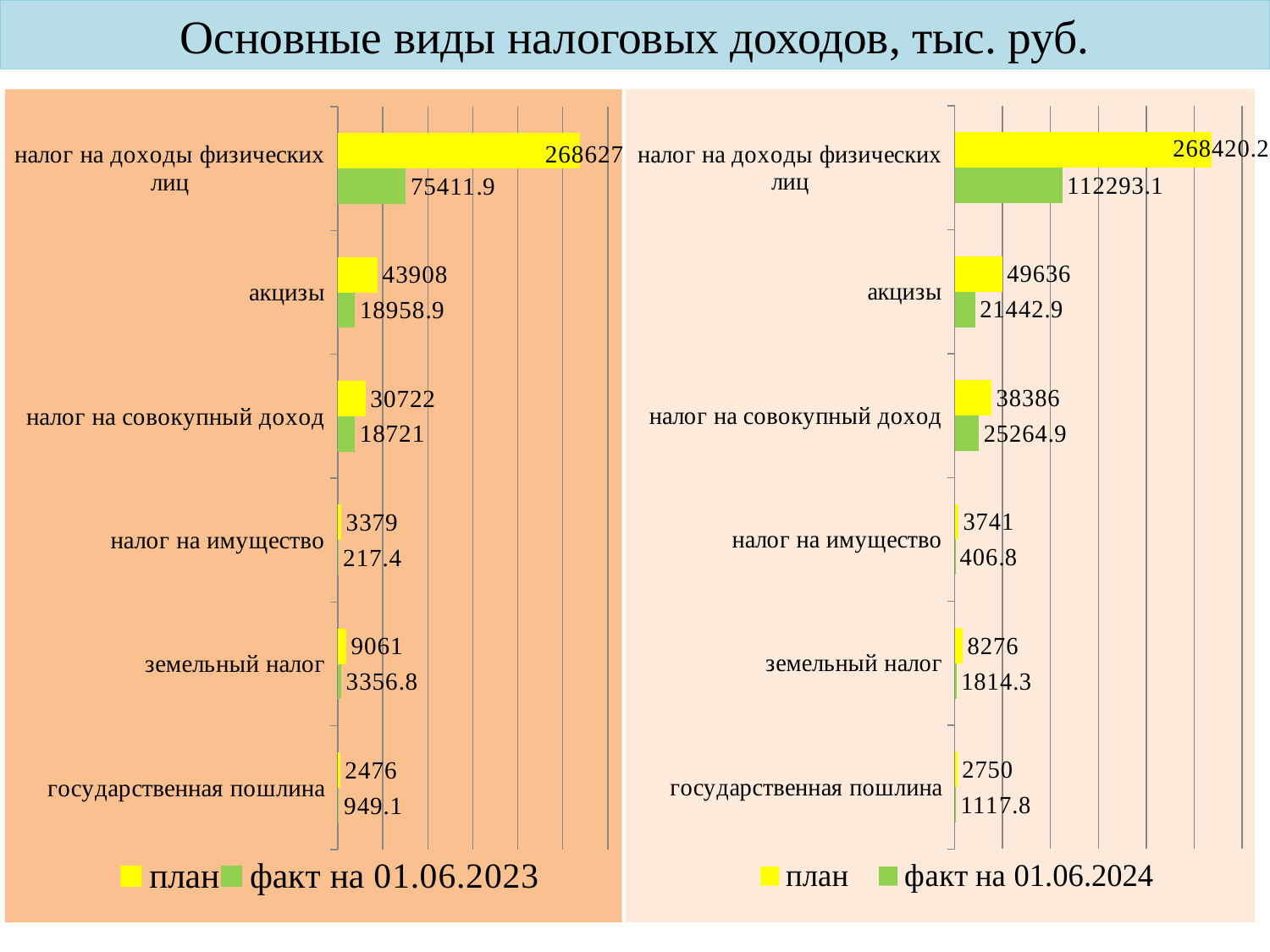
How many series does the legend of the right chart (факт на 01.06.2024) list? 2 In the right chart (факт на 01.06.2024), what is the difference between the план and факт values for земельный налог? 6461.7 What type of chart is the left chart (факт на 01.06.2023)? bar chart In the left chart (факт на 01.06.2023), which category has the highest план value? налог на доходы физических лиц In the right chart (факт на 01.06.2024), which is larger: the факт value for акцизы or the факт value for налог на совокупный доход? налог на совокупный доход In the left chart (факт на 01.06.2023), what is the план value for акцизы? 43908 In the right chart (факт на 01.06.2024), which category has the lowest факт value? налог на имущество In the left chart (факт на 01.06.2023), what is the факт value for налог на имущество? 217.4 In the left chart (факт на 01.06.2023), what is the difference between the план and факт values for акцизы? 24949.1 In the right chart (факт на 01.06.2024), what is the план value for государственная пошлина? 2750 How many categories are shown in the left chart (факт на 01.06.2023)? 6 In the right chart (факт на 01.06.2024), what is the факт value for налог на доходы физических лиц? 112293.1